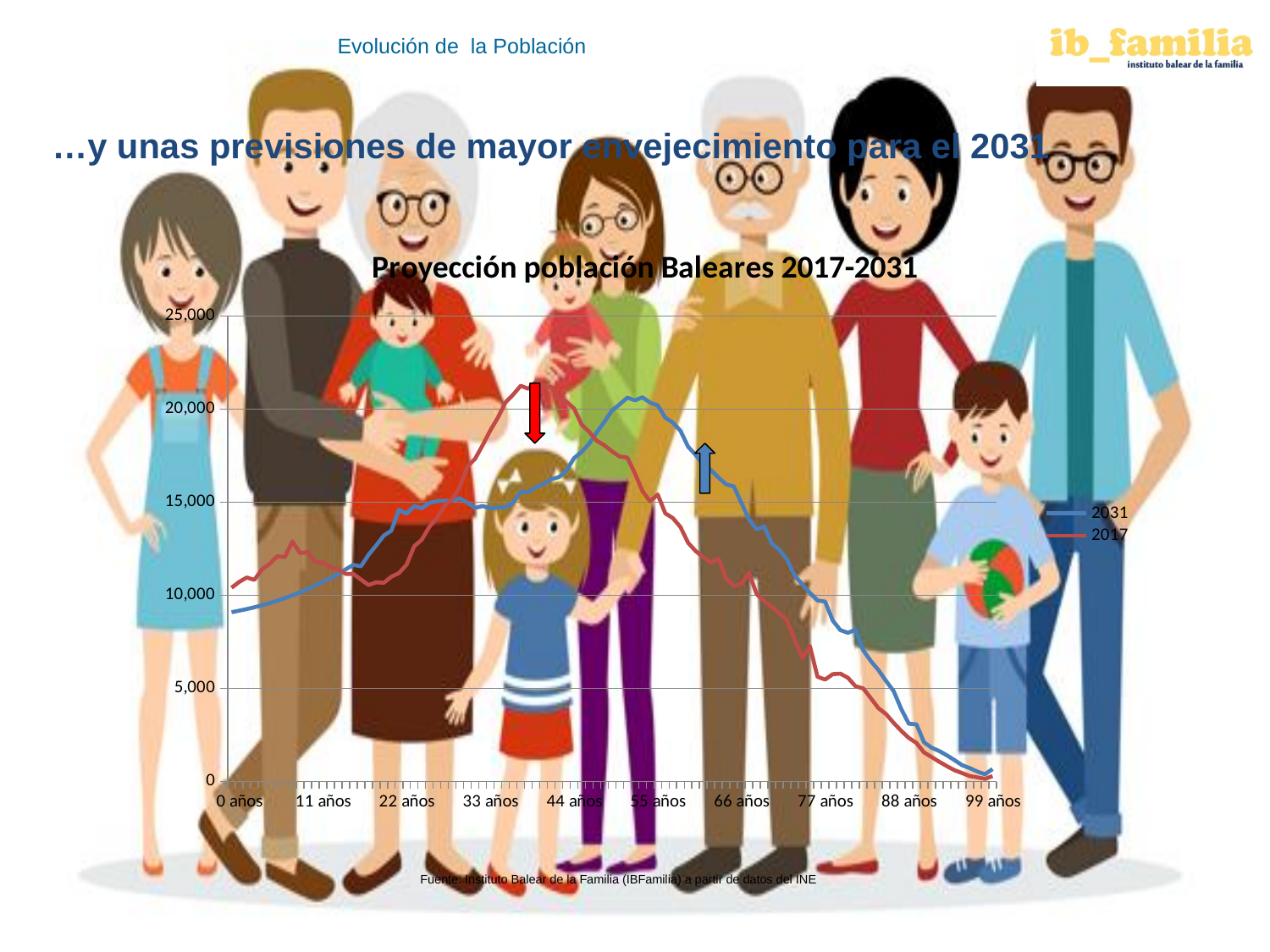
Is the value of the 2017 series at 99 años greater or less than 5,000? less How many age labels are shown along the x axis of the chart? 10 At 11 años, which series has the larger value, 2031 or 2017? 2017 Is the value of the 2031 series at 0 años greater or less than 10,000? less At 55 años, which series has the larger value, 2031 or 2017? 2031 What are the two series named in the chart legend? 2031 and 2017 What kind of chart is shown on the slide? line chart Does the 2017 series rise or fall between 66 años and 99 años? fall What is the title of the chart? Proyección población Baleares 2017-2031 How many series does the legend of the chart list? 2 Is the value of the 2031 series at 88 años greater or less than 5,000? less